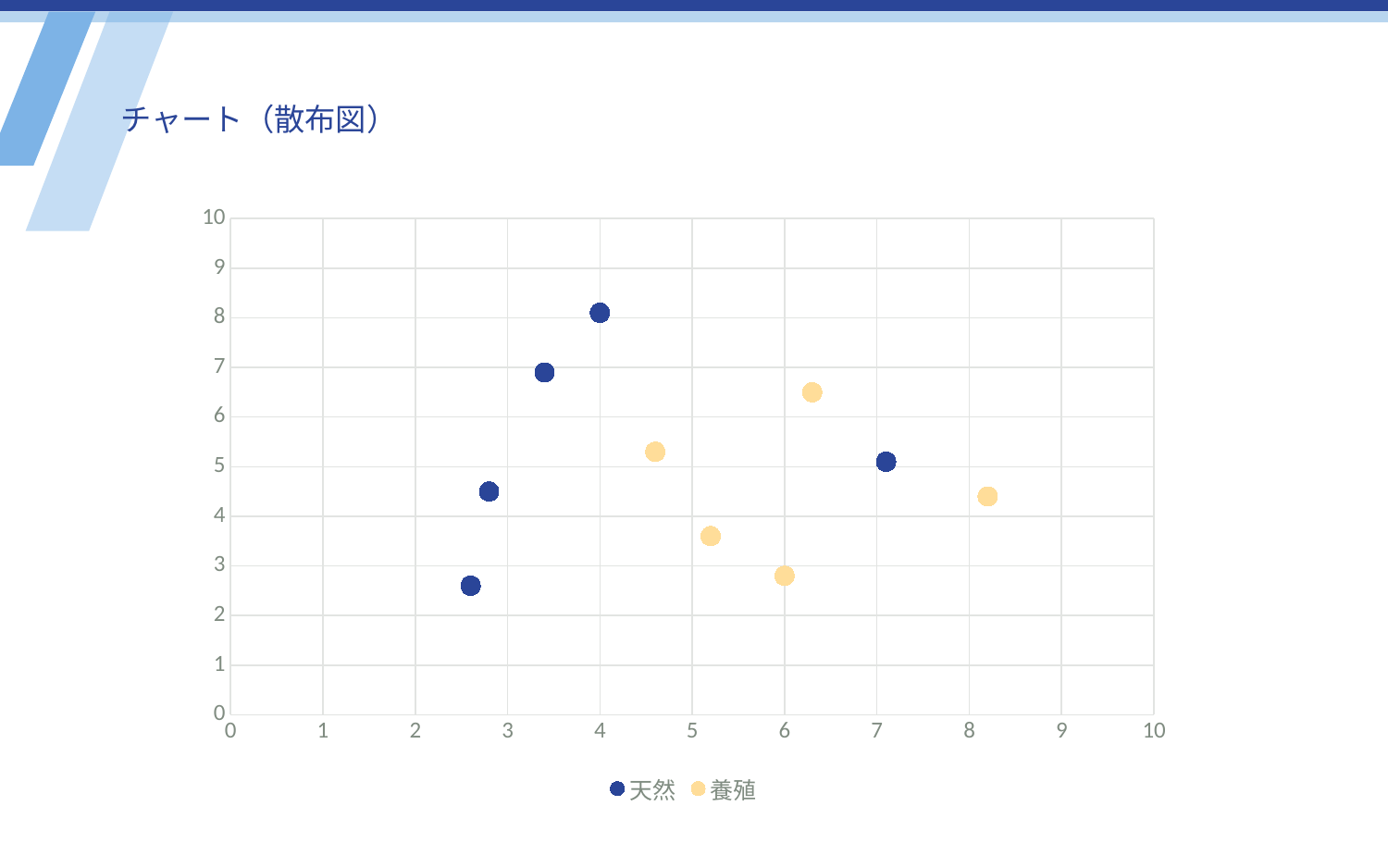
How many series does the legend list? 2 How many 天然 points are plotted on the chart? 5 Which series contains the point with the highest y value? 天然 How many 養殖 points are plotted on the chart? 5 How many points are plotted in total across both series? 10 What kind of chart is shown on the slide? scatter chart Is the y value of the highest 天然 point greater or less than 7? greater Is the y value of the 養殖 point with the largest x value greater or less than 5? less Is the y value of the highest 養殖 point greater or less than 6? greater What are the two series names shown in the legend? 天然 and 養殖 What is the title of the slide? チャート（散布図） Which series contains the point with the largest x value? 養殖